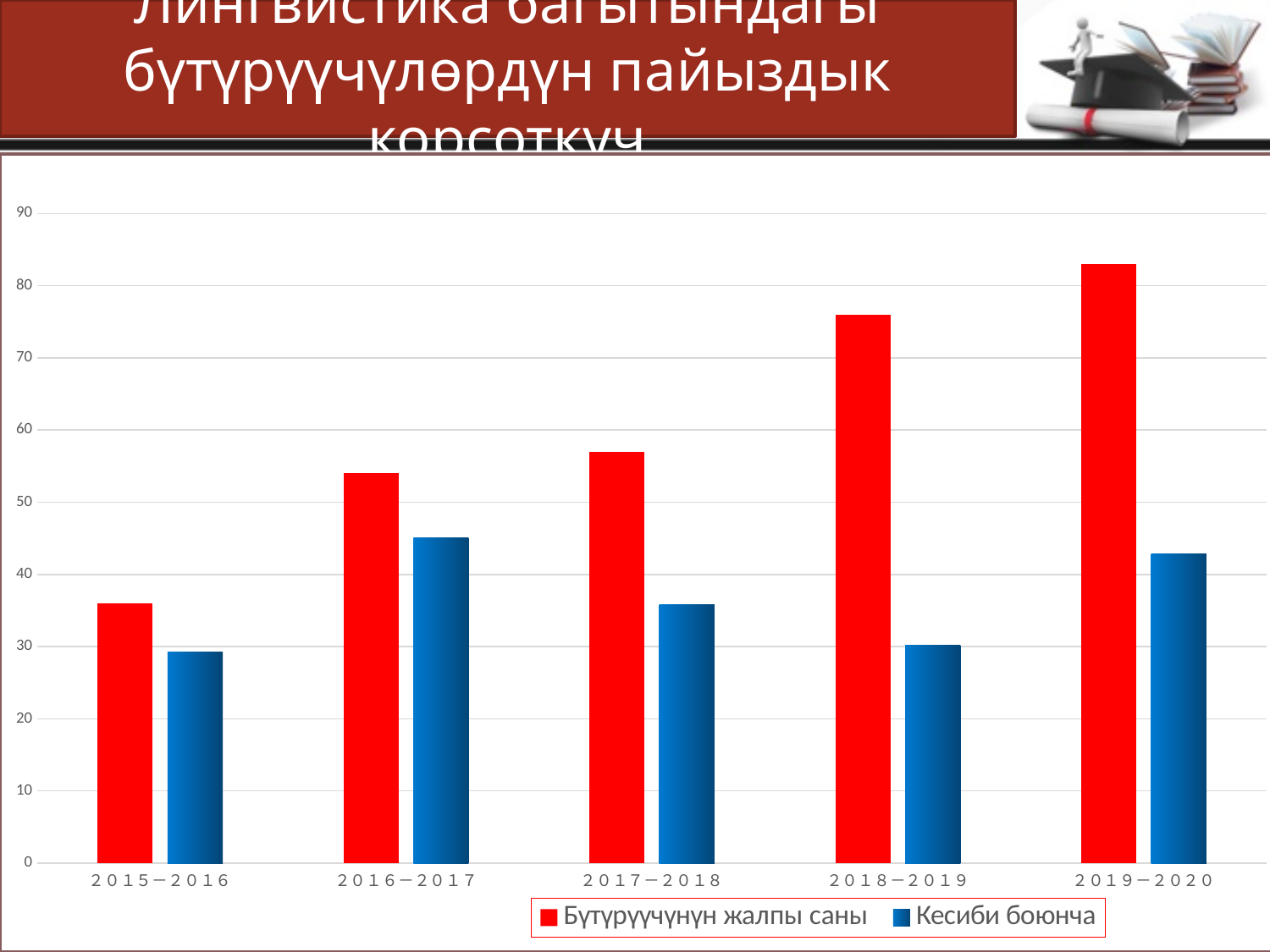
What kind of chart is shown on the slide? Bar chart Which year has the lowest value for Бүтүрүүчүнүн жалпы саны? 2015—2016 In 2018—2019, which series has the larger value: Бүтүрүүчүнүн жалпы саны or Кесиби боюнча? Бүтүрүүчүнүн жалпы саны How many series does the legend list? 2 How many academic-year categories are shown on the x axis? 5 Does the value for Бүтүрүүчүнүн жалпы саны rise or fall from 2015—2016 to 2019—2020? Rise Is the value for Бүтүрүүчүнүн жалпы саны in 2015—2016 greater or less than 40? less Is the value for Кесиби боюнча in 2016—2017 greater or less than 50? less Which year has the highest value for Бүтүрүүчүнүн жалпы саны? 2019—2020 Is the value for Бүтүрүүчүнүн жалпы саны in 2019—2020 greater or less than 80? greater Which colour represents the series Кесиби боюнча in the legend? Blue